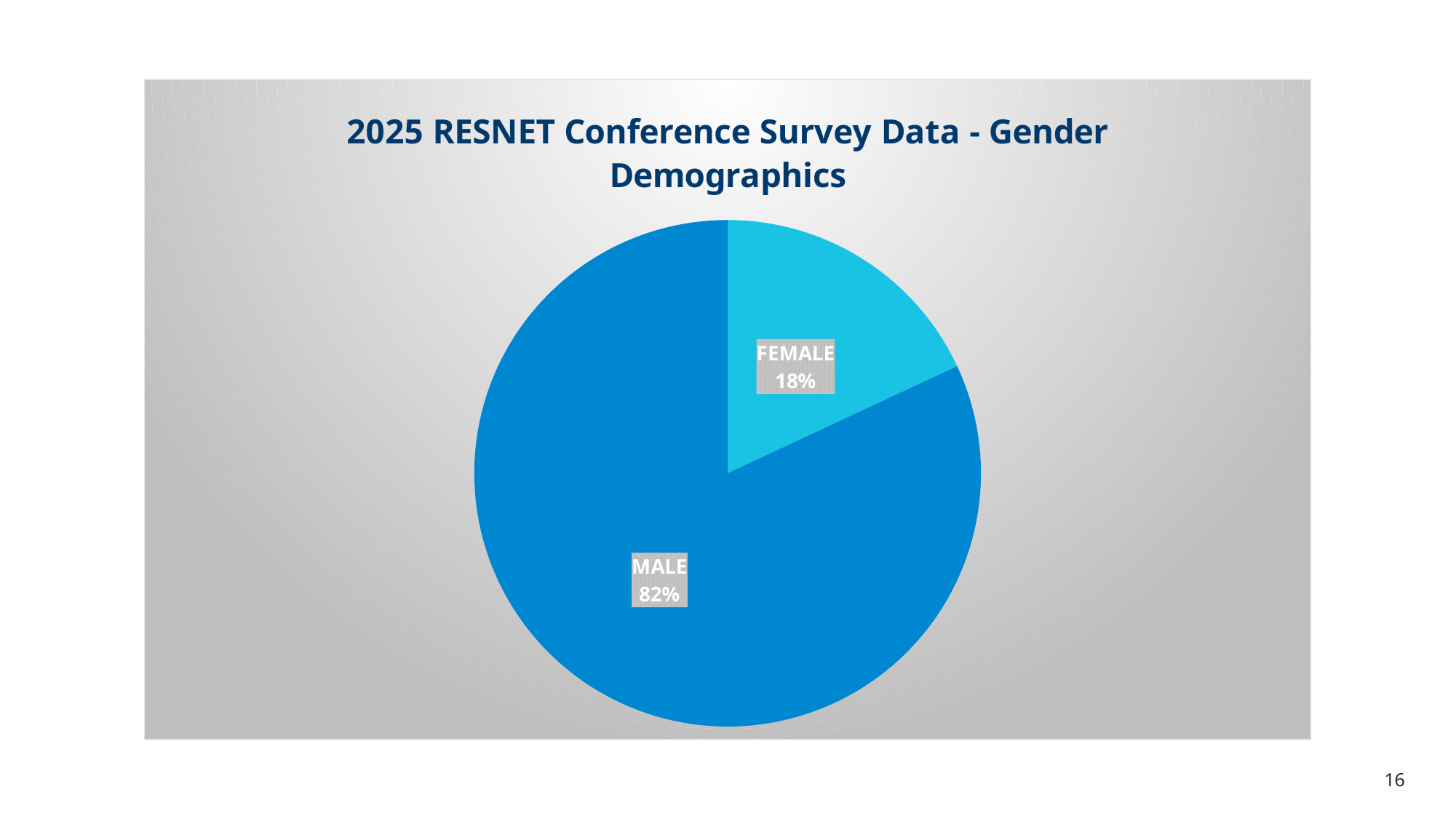
What percentage of survey respondents are male? 82% Which is larger, the male share or the female share? MALE What share of the pie does the FEMALE slice represent? 18% How many categories are shown in the pie chart? 2 What percentage of survey respondents are female? 18% What is the difference in percentage points between the male and female shares? 64 Which gender category has the smallest share of the pie? FEMALE What is the title of the chart? 2025 RESNET Conference Survey Data - Gender Demographics Which gender category has the largest share of the pie? MALE What kind of chart is shown on the slide? Pie chart Which slice is shown in the lighter blue colour? FEMALE